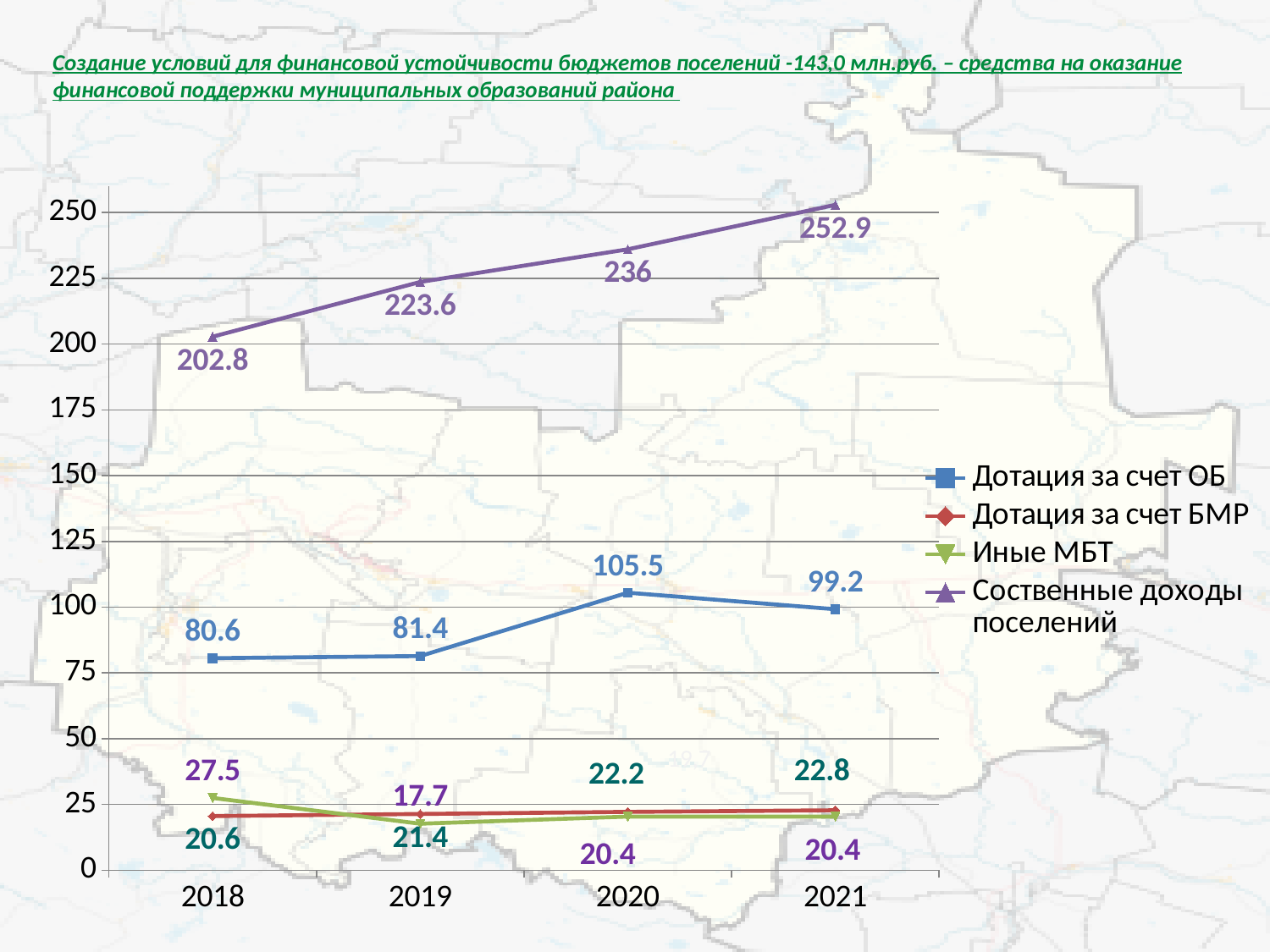
Do the values of Собственные доходы поселений rise or fall from 2018 to 2021? rise What type of chart is shown on the slide? line chart What is the difference between Собственные доходы поселений in 2021 and in 2018? 50.1 How many years are shown on the x axis? 4 Which is larger in 2021: Дотация за счет ОБ or Собственные доходы поселений? Собственные доходы поселений What is the value of Дотация за счет ОБ in 2020? 105.5 Is the value of Дотация за счет ОБ in 2019 greater or less than 100? less What is the value of Собственные доходы поселений in 2018? 202.8 What is the value of Собственные доходы поселений in 2021? 252.9 In which year is Собственные доходы поселений lowest? 2018 In which year is Дотация за счет ОБ highest? 2020 How many series does the legend list? 4